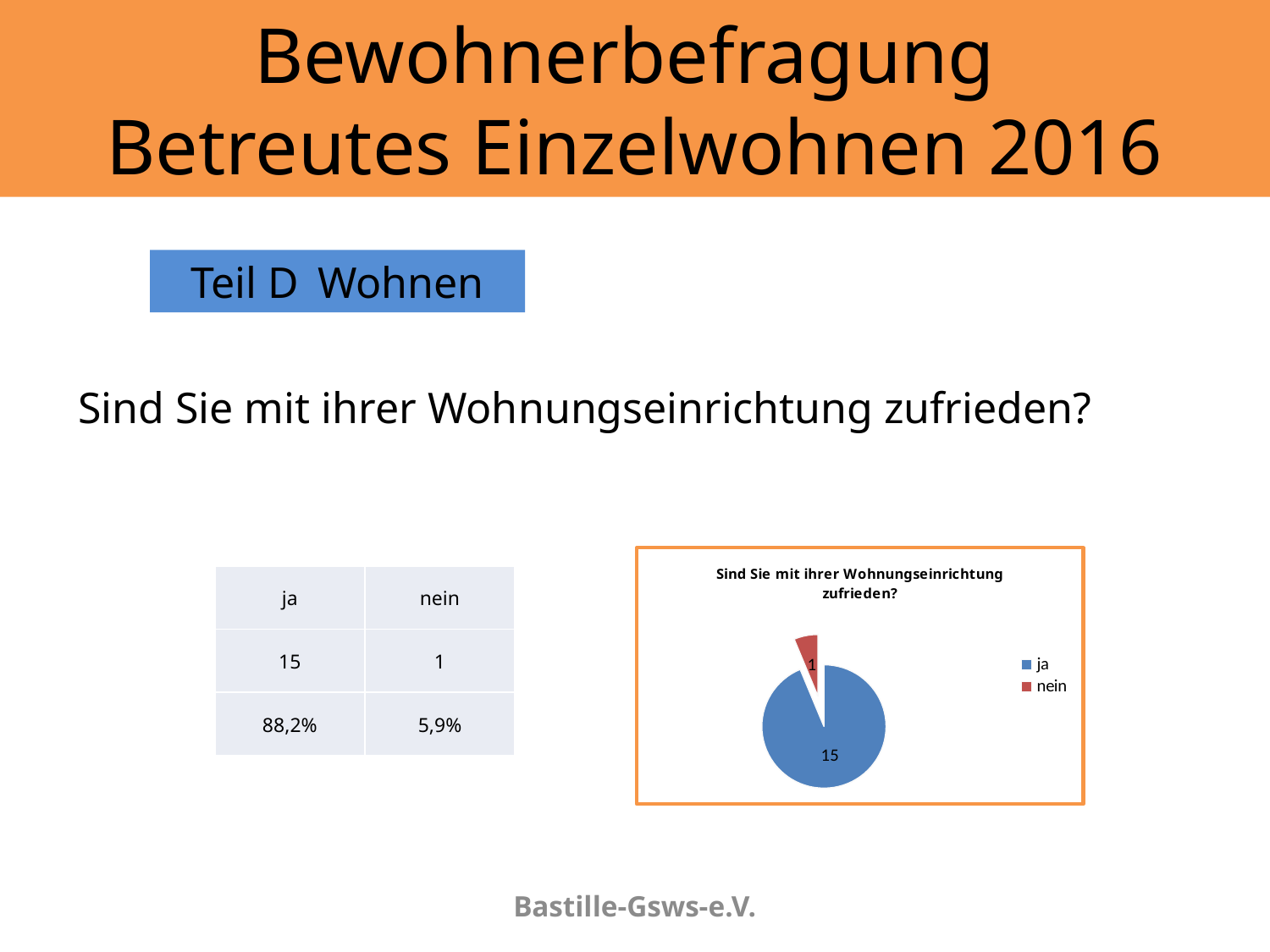
What is the value of the "nein" slice in the pie chart? 1 What is the value of the "ja" slice in the pie chart? 15 How many entries does the legend of the pie chart list? 2 How many slices does the pie chart have? 2 What is the title of the pie chart? Sind Sie mit ihrer Wohnungseinrichtung zufrieden? What kind of chart is shown on the slide? pie chart Which is larger in the pie chart, "ja" or "nein"? ja Which category has the largest slice in the pie chart? ja What is the difference between the "ja" and "nein" values in the pie chart? 14 Which category has the smallest slice in the pie chart? nein What is the total of all slices in the pie chart? 16 What colour is the "nein" slice in the pie chart? red